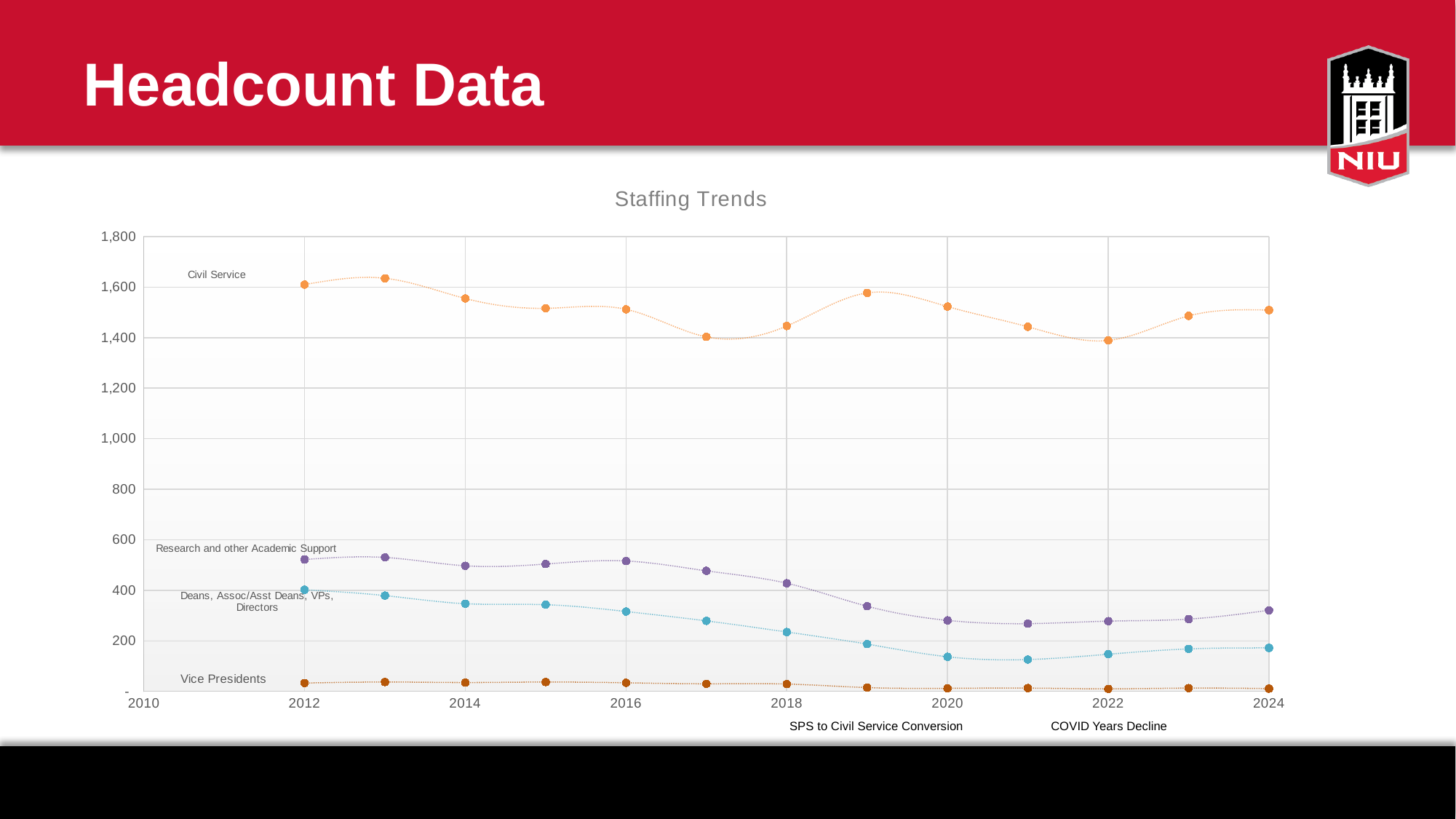
What kind of chart is shown on the slide? Line chart Does the Deans, Assoc/Asst Deans, VPs, Directors series rise or fall from 2012 to 2021? fall Is the Deans, Assoc/Asst Deans, VPs, Directors value for 2021 greater or less than 200? less Which series has the lowest values across all years? Vice Presidents Which year has the larger Research and other Academic Support value, 2016 or 2020? 2016 Is the Civil Service value for 2019 greater or less than 1,400? greater How many staffing series are labelled on the chart? 4 Is the Research and other Academic Support value for 2012 greater or less than 400? greater What is the title of the chart? Staffing Trends How many years have data points plotted for the Civil Service series? 13 Which year has the larger Civil Service value, 2013 or 2022? 2013